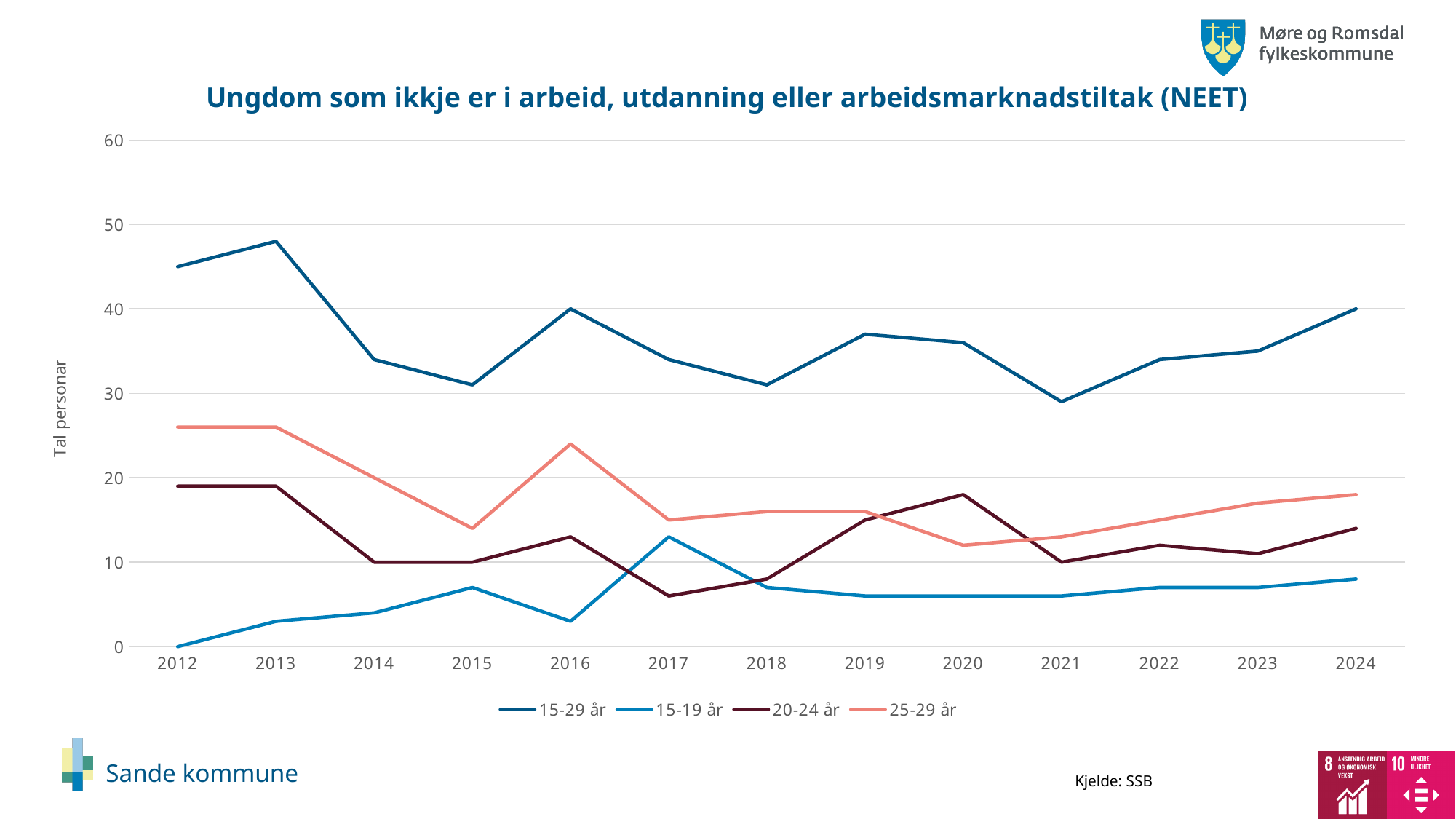
Is the value for 15-29 år in 2013 greater or less than 40? greater Which series has the higher value in 2017: 15-19 år or 20-24 år? 15-19 år What is the value for 15-19 år in 2012? 0 In which year does the 15-29 år series reach its lowest value? 2021 How many years are shown along the x axis? 13 What is the value for 15-29 år in 2016? 40 What is the label of the y axis? Tal personar In which year does the 15-29 år series reach its highest value? 2013 What kind of chart is shown on the slide? line chart Is the value for 25-29 år in 2020 greater or less than 20? less How many series does the legend list? 4 What is the value for 20-24 år in 2014? 10